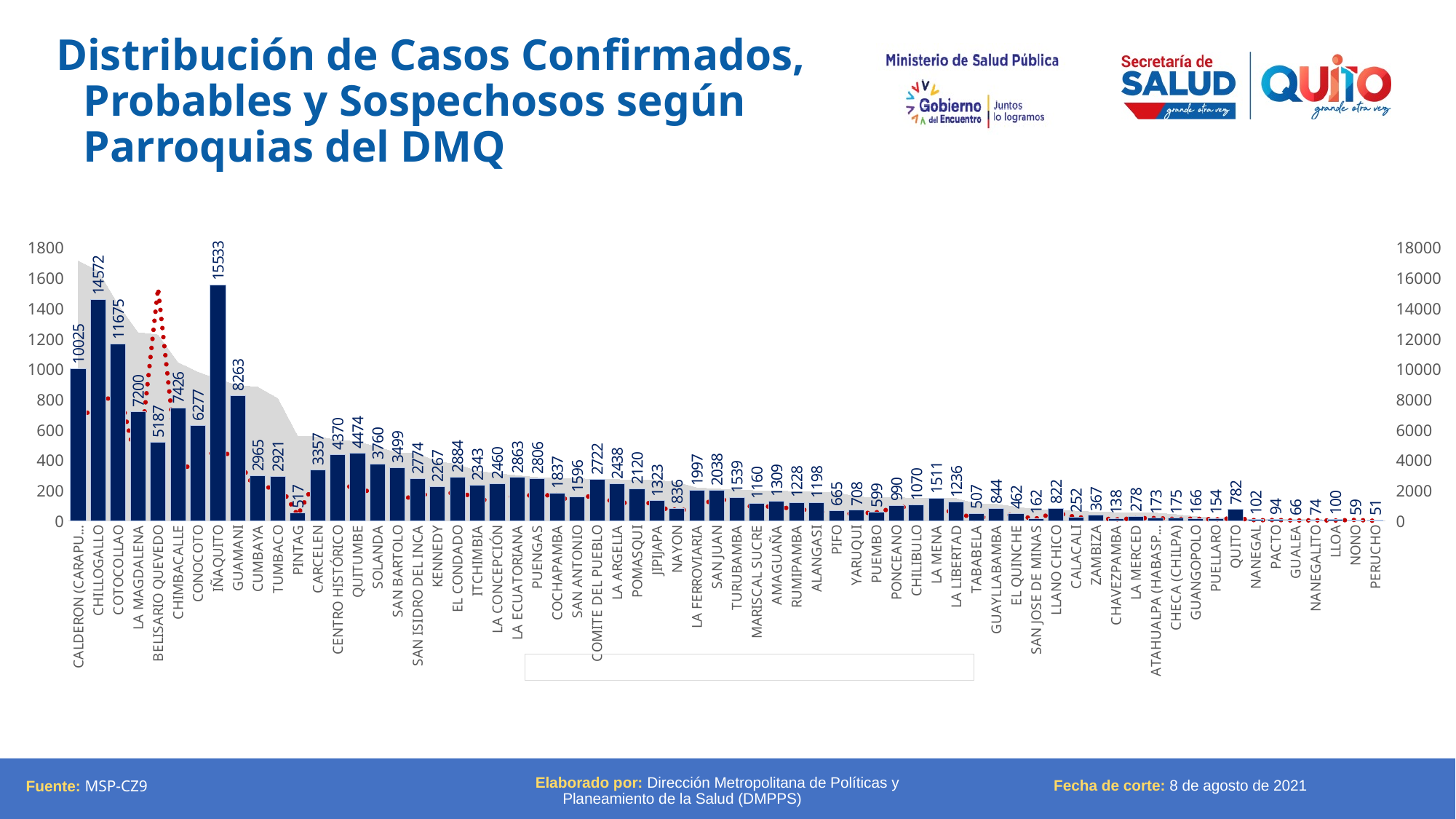
Which has a larger value, QUITUMBE or CENTRO HISTÓRICO? QUITUMBE What is the difference between the values for IÑAQUITO and CHILLOGALLO? 961 What is the value shown for CHILLOGALLO? 14572 What kind of chart is used to show the parish values? Bar chart What is the value shown for PINTAG? 517 Which has a larger value, COTOCOLLAO or CALDERON (CARAPU...)? COTOCOLLAO Which parish has the lowest bar? PERUCHO What is the value shown for CUMBAYA? 2965 What is the value shown for QUITO? 782 Which parish has the highest bar? IÑAQUITO What is the title of the slide's chart? Distribución de Casos Confirmados, Probables y Sospechosos según Parroquias del DMQ What is the value shown for IÑAQUITO? 15533